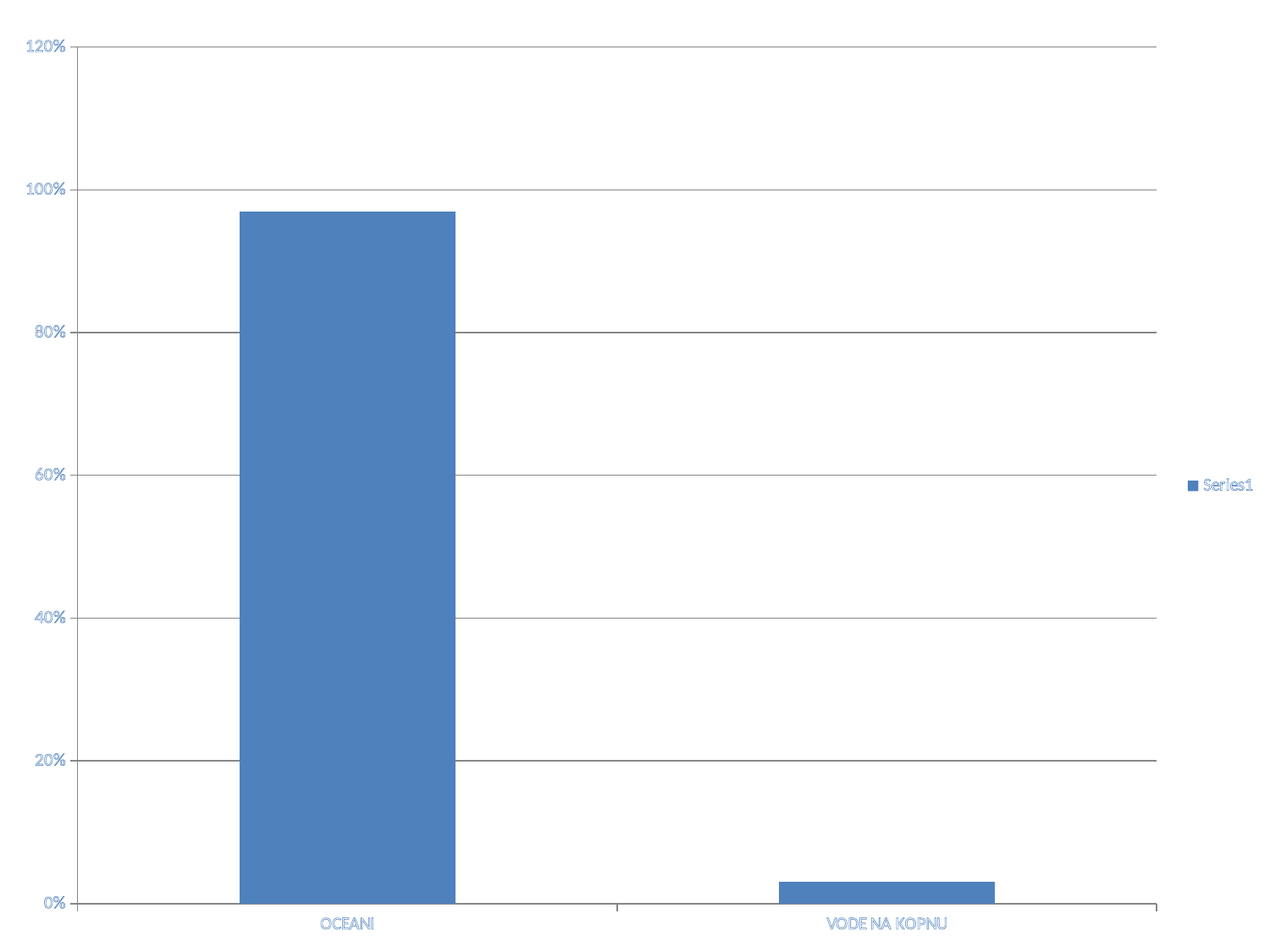
How many series does the legend list? 1 Is the value for VODE NA KOPNU greater or less than 20%? less What kind of chart is shown on the slide? bar chart Which category has the lowest value? VODE NA KOPNU Is the value for OCEANI greater or less than 100%? less What is the highest value shown on the y axis? 120% Which category has the highest value? OCEANI What is the name of the series shown in the legend? Series1 Which is larger, the value for OCEANI or the value for VODE NA KOPNU? OCEANI Is the value for OCEANI greater or less than 80%? greater How many categories are shown on the x axis? 2